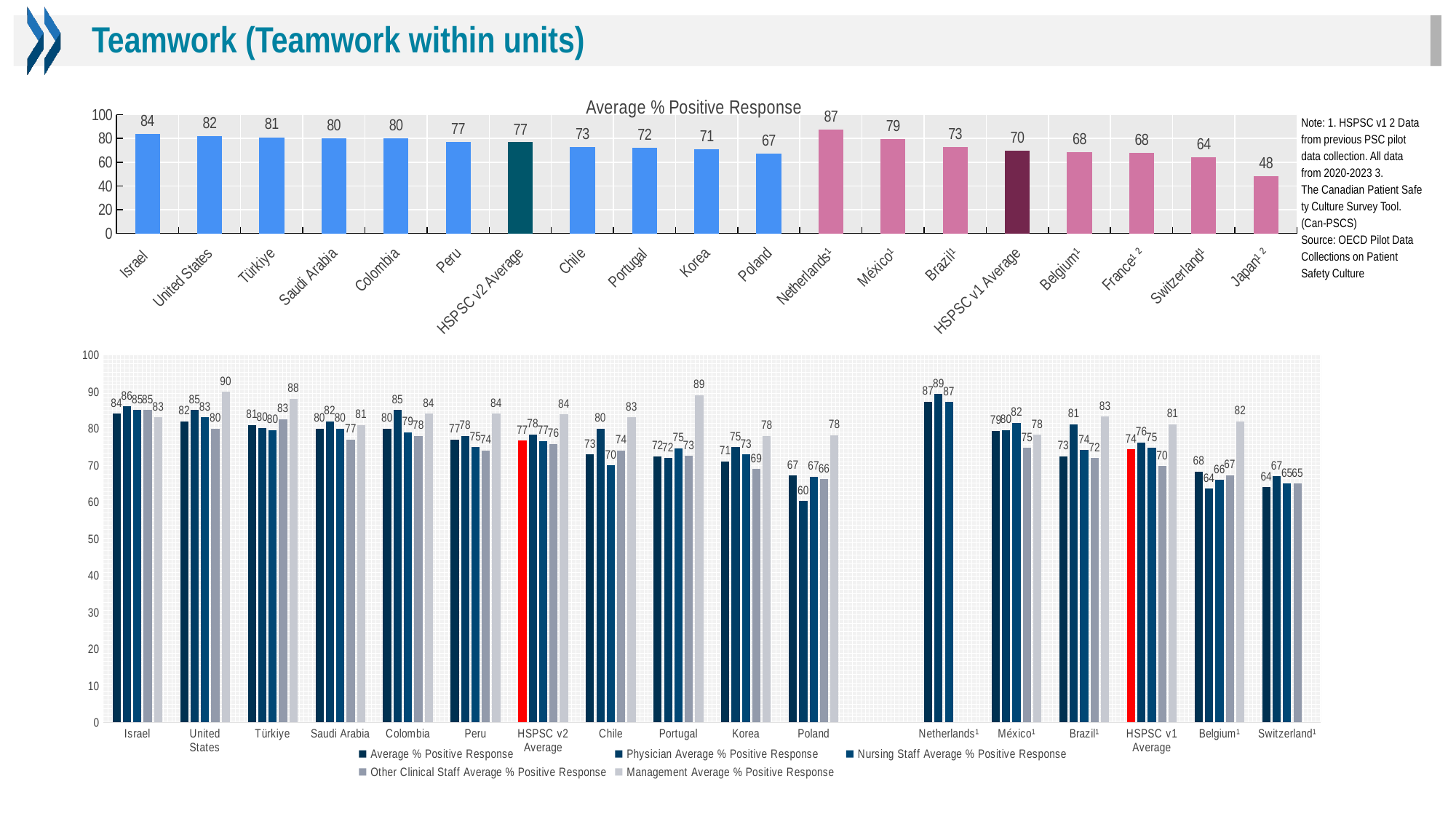
In the bottom chart, what is the Physician Average % Positive Response value for Poland? 60 In the top chart (Average % Positive Response), which is larger, the value for Korea or the value for México? México In the top chart (Average % Positive Response), what is the difference between the values for Netherlands and Japan? 39 What kind of chart is the top chart (Average % Positive Response)? Bar chart In the bottom chart, what is the Management Average % Positive Response value for United States? 90 In the bottom chart, what is the difference between the Management and Physician Average % Positive Response values for Portugal? 17 In the top chart (Average % Positive Response), which category has the lowest value? Japan In the top chart (Average % Positive Response), what is the value for Israel? 84 In the top chart (Average % Positive Response), which category has the highest value? Netherlands In the top chart (Average % Positive Response), how many categories are shown on the x axis? 19 In the bottom chart, how many series does the legend list? 5 In the bottom chart, which bars are coloured red? HSPSC v2 Average and HSPSC v1 Average (Average % Positive Response)